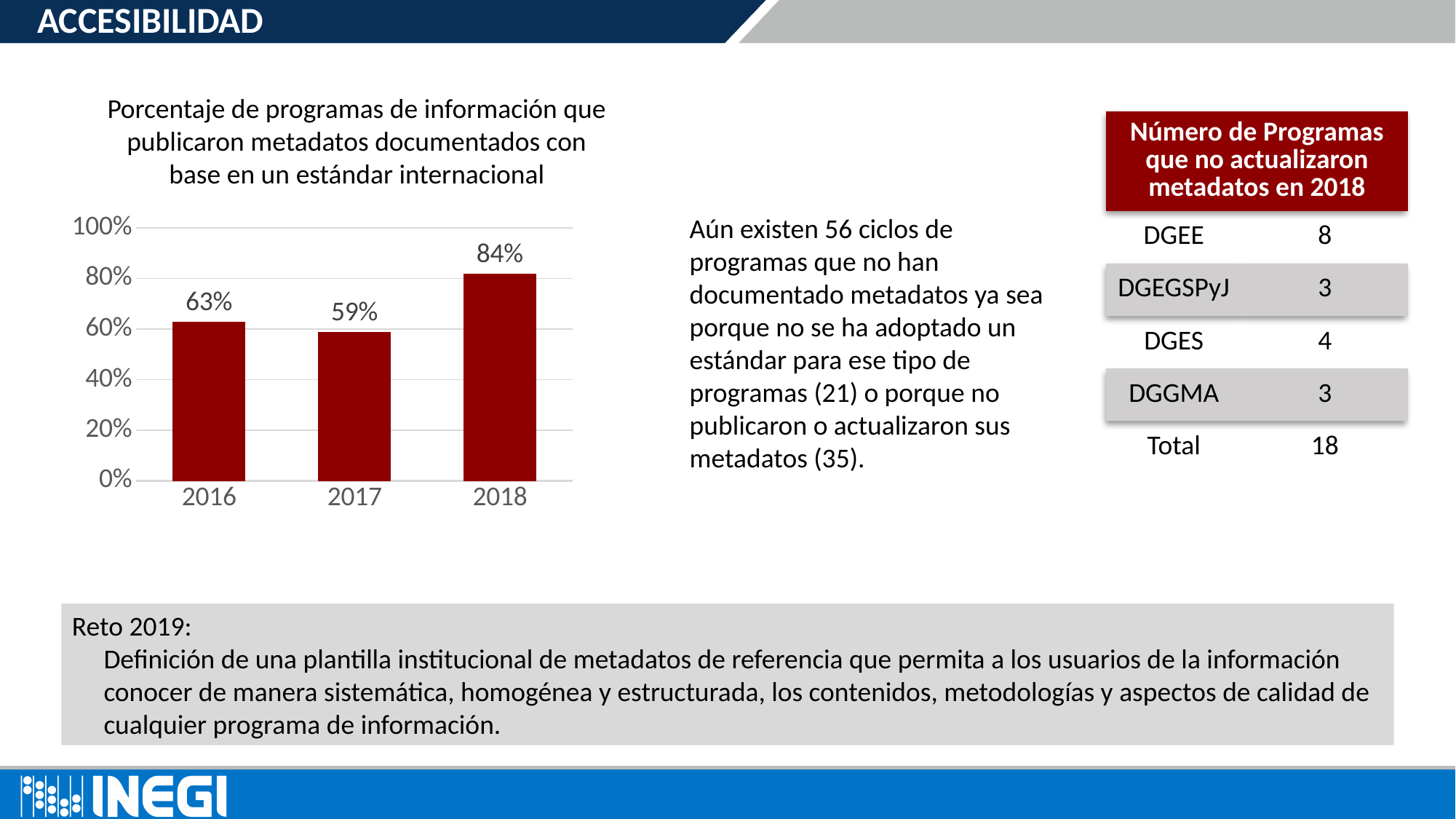
Which is larger, the value for 2016 or the value for 2018? 2018 What is the value for 2016? 63% What is the value for 2017? 59% What is the value for 2018? 84% What is the title of the chart? Porcentaje de programas de información que publicaron metadatos documentados con base en un estándar internacional What is the difference between the values for 2018 and 2017? 25% How many years are shown on the x axis? 3 Which year has the highest value? 2018 Which year has the lowest value? 2017 What kind of chart is shown? bar chart What is the difference between the values for 2016 and 2017? 4% Is the value for 2018 greater or less than 80%? greater